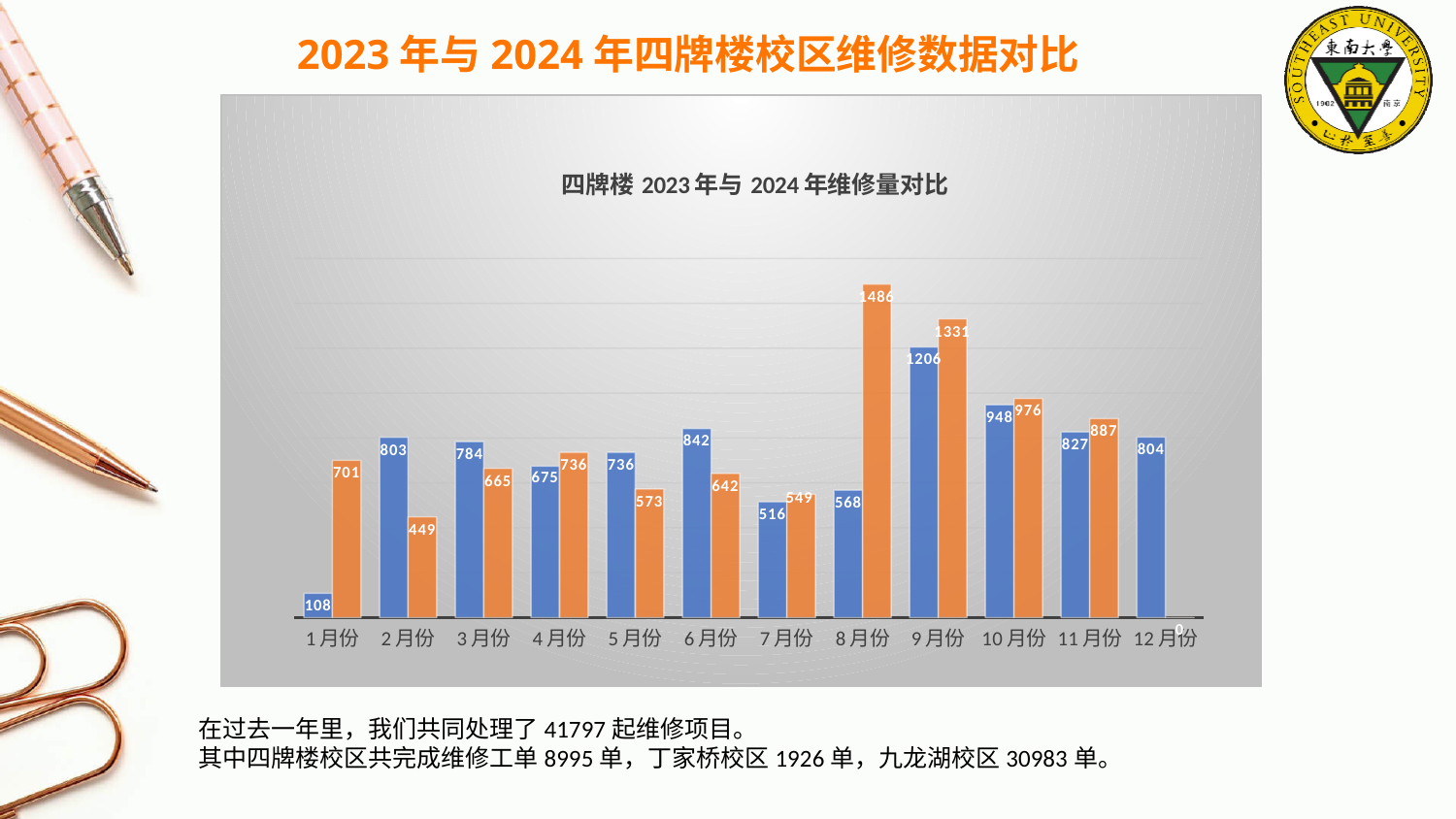
What kind of chart is shown on the slide? bar chart What is the value of the orange bar for 8月份? 1486 What is the title of the chart? 四牌楼 2023年与 2024年维修量对比 What is the value of the blue bar for 1月份? 108 What is the value of the blue bar for 12月份? 804 For 1月份, what is the difference between the orange bar (701) and the blue bar (108)? 593 Which month has the lowest blue bar? 1月份 For 2月份, which bar is larger, the blue bar or the orange bar? blue bar Which month has the highest blue bar? 9月份 How many month categories are shown on the x axis of the chart? 12 For 9月份, what is the difference between the orange bar (1331) and the blue bar (1206)? 125 Which month has the highest orange bar? 8月份